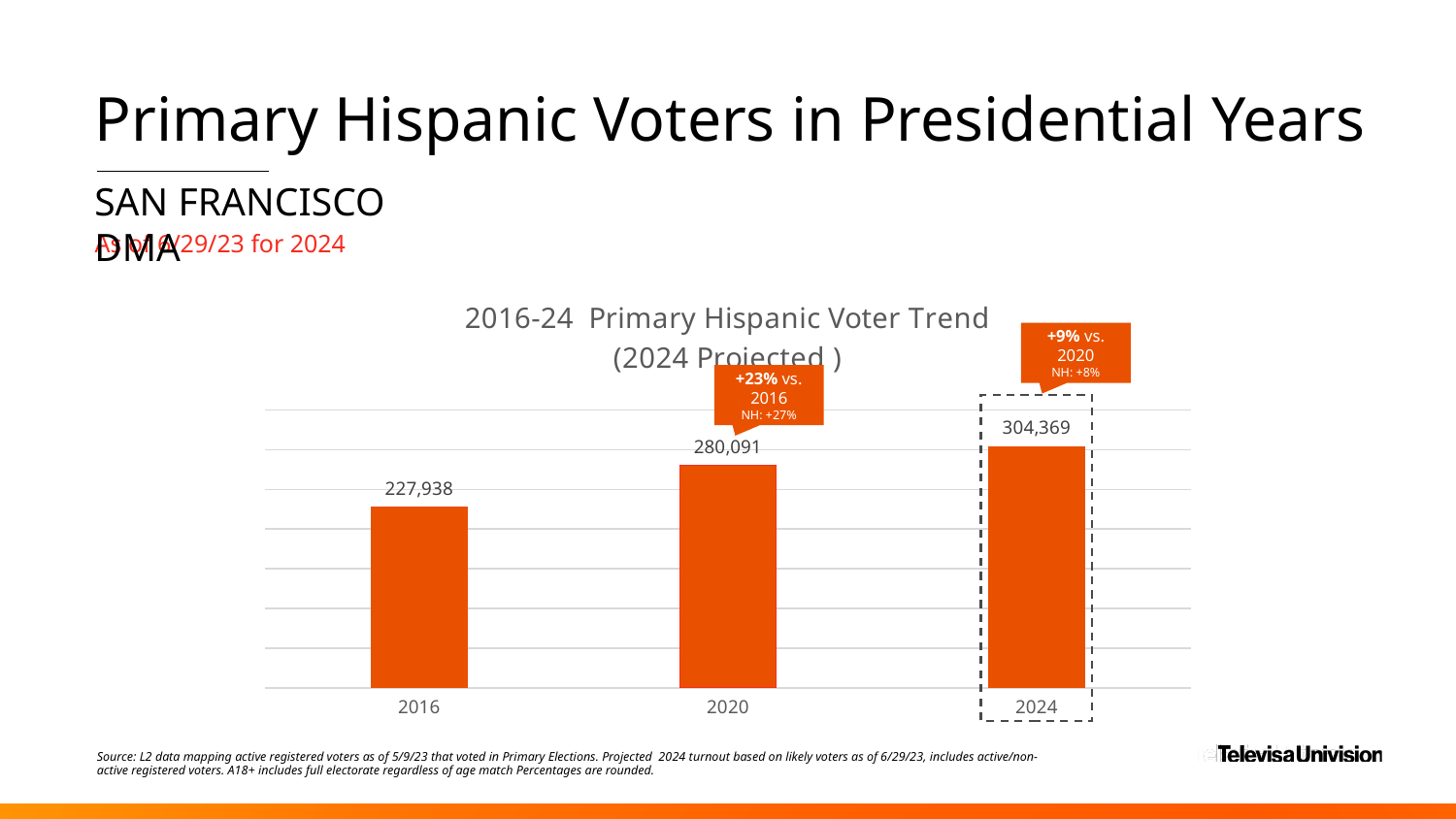
Which year has the lowest value in the chart? 2016 How many years are plotted in the chart? 3 Do the values rise or fall from 2016 to 2024? Rise What percentage change vs. 2016 is shown in the callout above the 2020 bar? +23% What is the value for 2020 in the Primary Hispanic Voter Trend chart? 280,091 What is the difference between the 2024 and 2020 values? 24,278 Which year has the highest value in the chart? 2024 What kind of chart is shown on the slide? Bar chart What is the value for 2016 in the Primary Hispanic Voter Trend chart? 227,938 What is the difference between the 2020 and 2016 values? 52,153 Which is larger, the value for 2016 or the value for 2020? 2020 What is the projected value for 2024 in the Primary Hispanic Voter Trend chart? 304,369